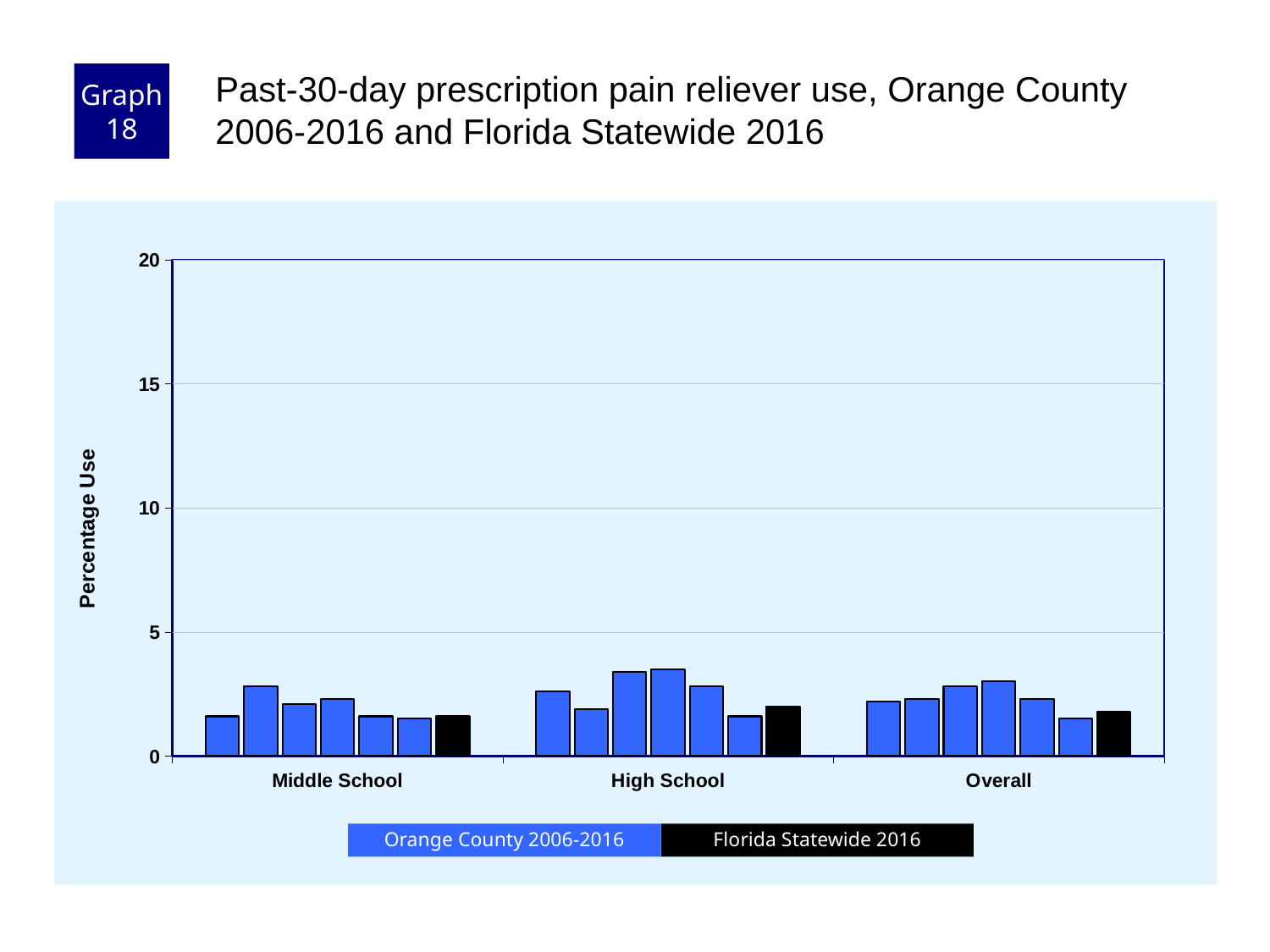
What is the label on the y axis? Percentage Use Is the highest Orange County bar for High School greater or less than 5? less What are the two series named in the legend? Orange County 2006-2016 and Florida Statewide 2016 Are any of the bars on the chart greater than 10? No How many categories are shown along the x axis? 3 How many series does the legend list? 2 What is the highest value shown on the y axis? 20 Is the Florida Statewide 2016 value for High School greater or less than 5? less What kind of chart is shown on the slide? bar chart How many bars are plotted for the Middle School category? 7 Which category contains the tallest bar on the chart? High School